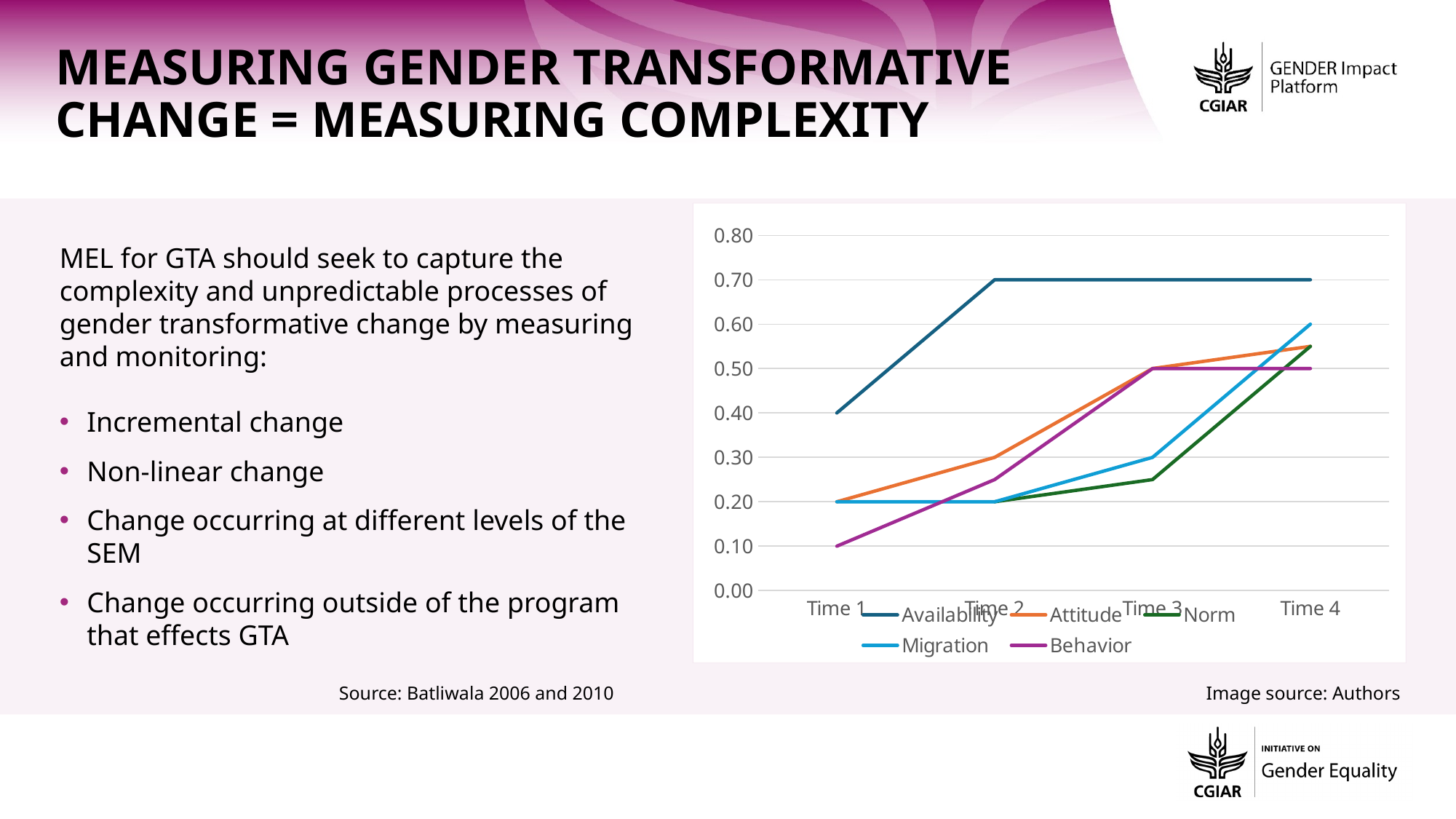
What kind of chart is shown on the slide? Line chart What is the value of Availability at Time 1? 0.40 Which series has the highest value at Time 4? Availability What is the value of Availability at Time 2? 0.70 How many time points are shown on the x axis of the chart? 4 How many series does the chart legend list? 5 What is the value of Behavior at Time 1? 0.10 By how much does Availability increase from Time 1 to Time 2? 0.30 Which is larger at Time 4, Migration or Behavior? Migration Which series has the lowest value at Time 1? Behavior Is the value for Norm at Time 3 greater or less than 0.30? less What is the value of Migration at Time 4? 0.60